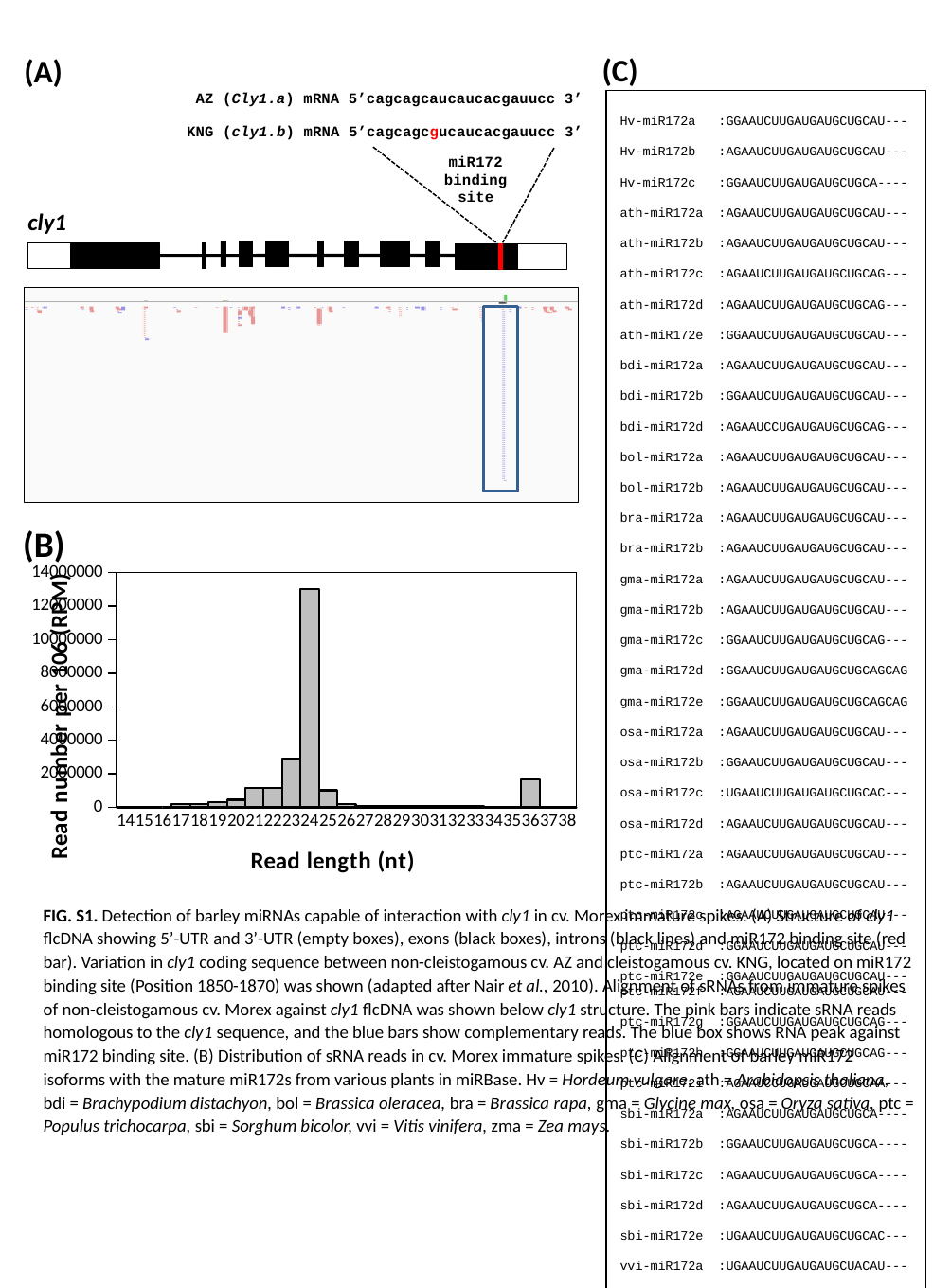
In the chart in panel (B), which is larger, the value for read length 23 or read length 36? 23 In the chart in panel (B), which is larger, the value for read length 24 or read length 23? 24 In the chart in panel (B), is the value for read length 23 greater or less than 2000000? greater What is the y-axis title of the chart in panel (B)? Read number per 10^6 (RPM) In the chart in panel (B), is the value for read length 21 greater or less than 2000000? less In the chart in panel (B), is the value for read length 24 greater or less than 12000000? greater In the chart in panel (B), which is larger, the value for read length 36 or read length 30? 36 What is the x-axis title of the chart in panel (B)? Read length (nt) What kind of chart is shown in panel (B)? bar chart How many read length categories are labelled on the x axis of the chart in panel (B)? 25 In the chart in panel (B), which read length has the highest read number? 24